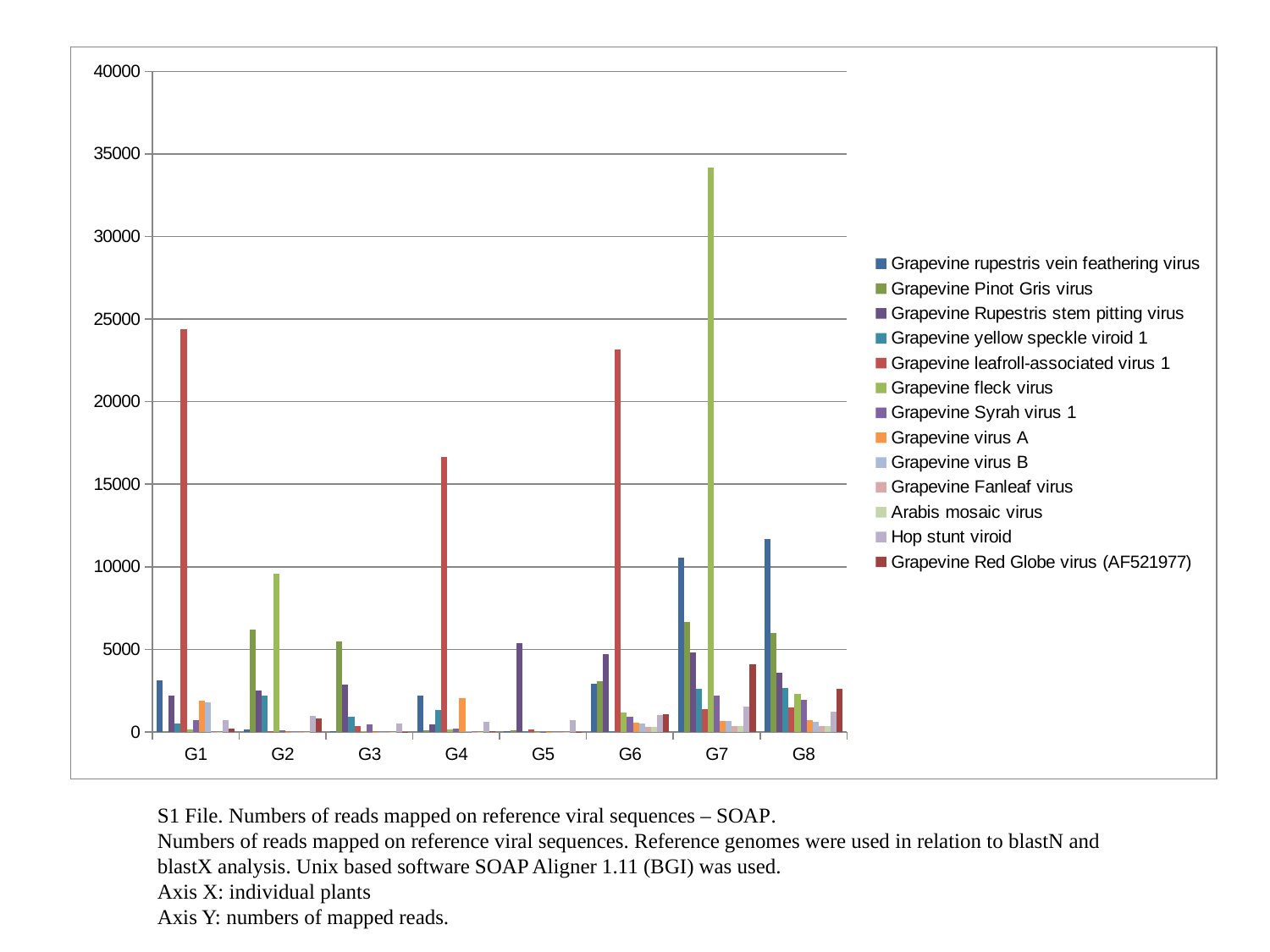
Which series has the tallest bar in the whole chart? Grapevine fleck virus Which is larger: Grapevine fleck virus at G7 or at G2? G7 How many plant categories are shown on the x axis? 8 How many series does the legend list? 13 Which is larger: Grapevine leafroll-associated virus 1 at G1 or at G4? G1 Is the value for Grapevine leafroll-associated virus 1 at G4 greater or less than 15000? greater At which plant does the Grapevine fleck virus series reach its highest value? G7 What kind of chart is shown on the slide? bar chart Is the value for Grapevine fleck virus at G2 greater or less than 10000? less Is the value for Grapevine fleck virus at G7 greater or less than 30000? greater